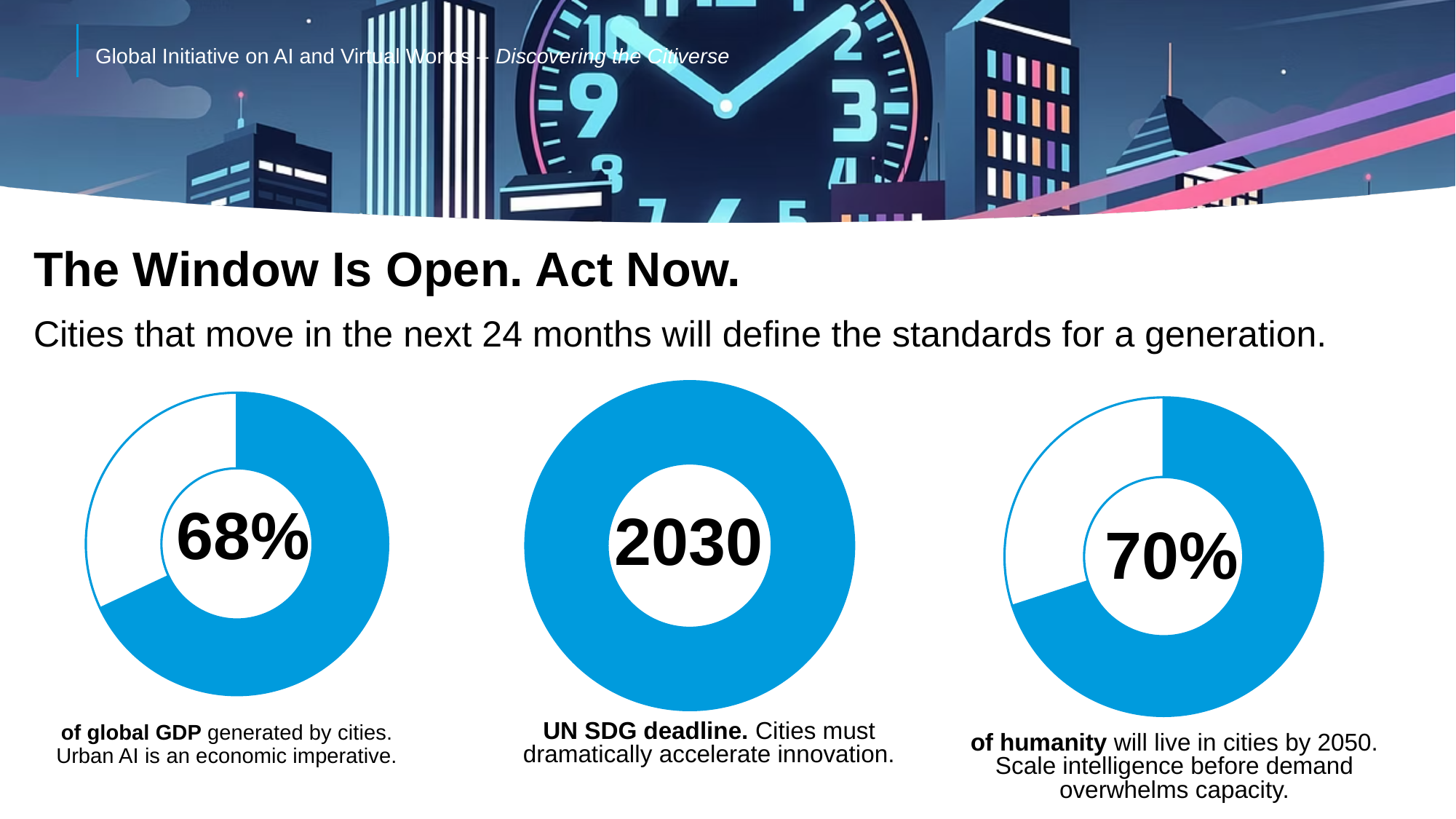
What kind of chart is used for the three figures on the slide? Donut (pie) chart What value is printed in the centre of the left donut chart? 68% According to the caption under the left donut chart, what does the 68% represent? Share of global GDP generated by cities According to the caption under the middle donut chart, what does 2030 represent? The UN SDG deadline What value is printed in the centre of the middle donut chart? 2030 What is the difference between the percentage in the right donut chart and the percentage in the left donut chart? 2% Which is larger, the percentage in the left donut chart or the percentage in the right donut chart? The right donut chart (70%) Is the filled share of the right donut chart greater or less than 50%? greater What value is printed in the centre of the right donut chart? 70% What share of the left donut chart is filled in blue? 68% How many donut charts are shown on the slide? 3